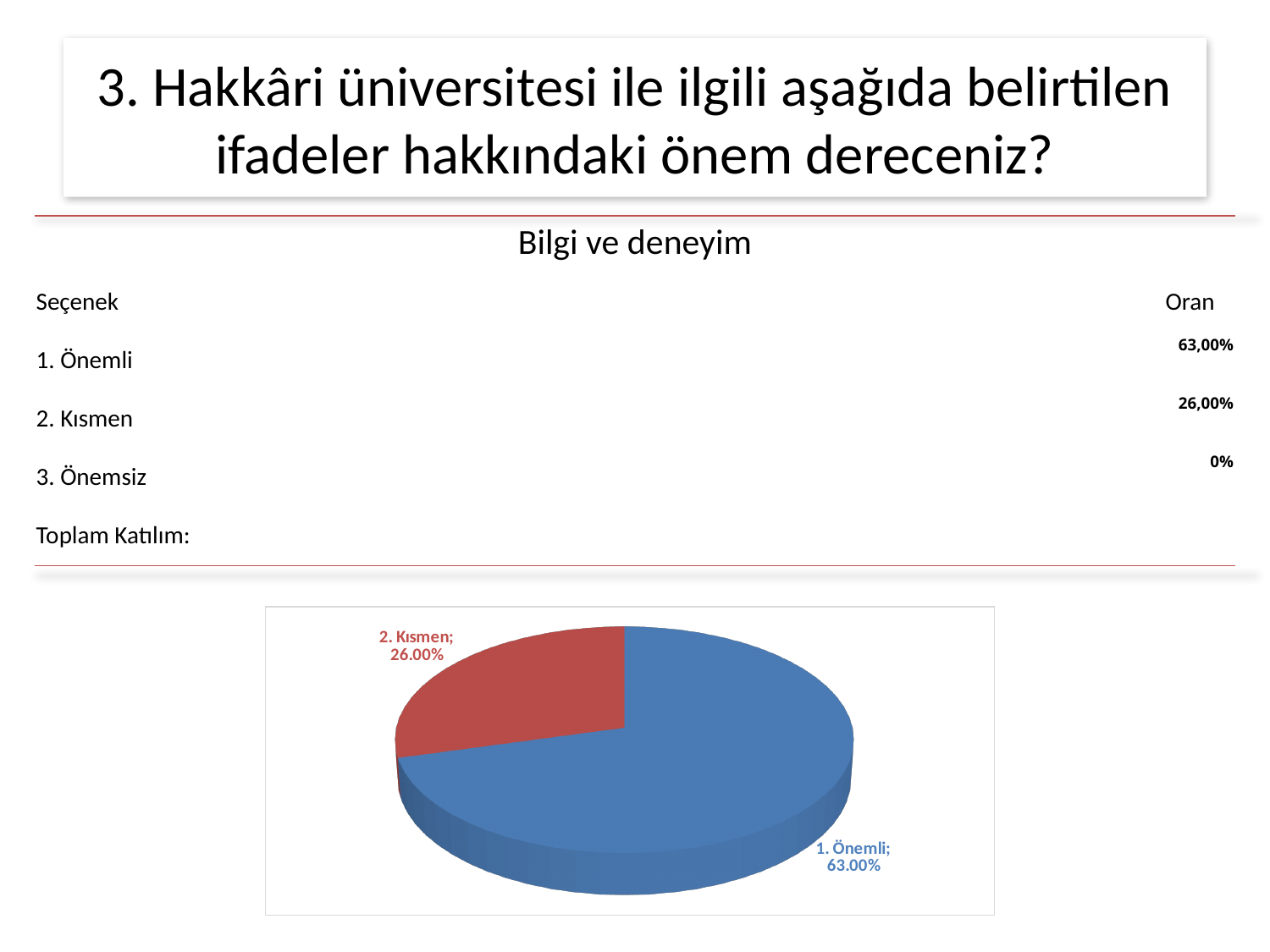
By how many percentage points does 1. Önemli exceed 2. Kısmen in the pie chart? 37.00% Which slice of the pie chart is the largest? 1. Önemli How many labelled slices does the pie chart have? 2 Is the share for 1. Önemli in the pie chart greater or less than 50%? greater What colour is the 1. Önemli slice in the pie chart? blue What percentage does the pie chart show for 1. Önemli? 63.00% What percentage does the pie chart show for 2. Kısmen? 26.00% What share of the pie does the 2. Kısmen slice represent? 26.00% Which is larger in the pie chart, 1. Önemli or 2. Kısmen? 1. Önemli What kind of chart is shown on the slide? pie chart Which labelled slice of the pie chart is the smallest? 2. Kısmen What colour is the 2. Kısmen slice in the pie chart? red